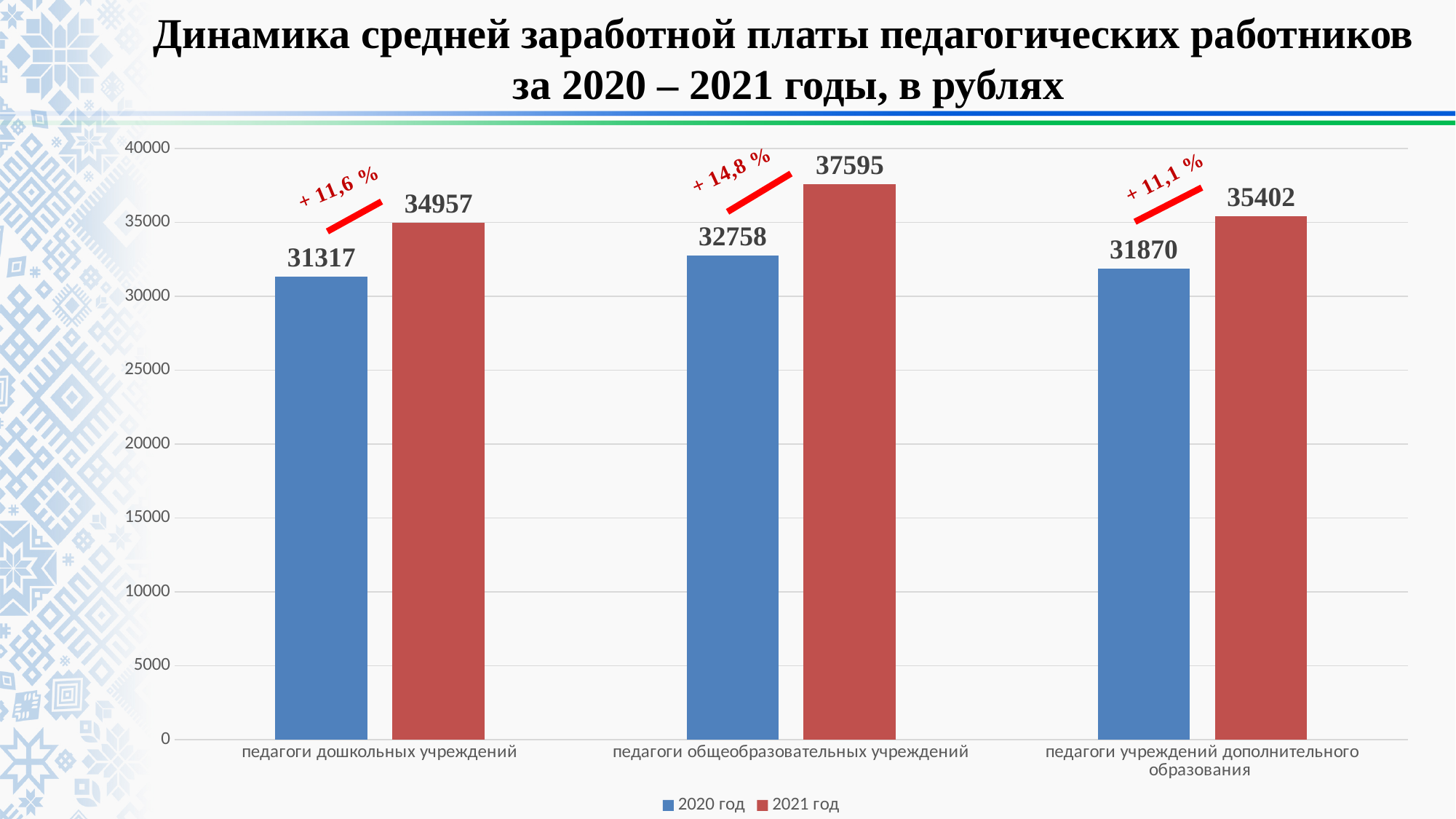
What is the difference between the 2021 год and 2020 год values for педагоги дошкольных учреждений? 3640 Is the 2021 год value for педагоги дошкольных учреждений greater or less than 35000? less Which is larger: the 2020 год value for педагоги учреждений дополнительного образования or the 2020 год value for педагоги общеобразовательных учреждений? педагоги общеобразовательных учреждений Which category has the highest 2021 год value? педагоги общеобразовательных учреждений What is the difference between the 2021 год and 2020 год values for педагоги общеобразовательных учреждений? 4837 How many categories are shown on the x axis? 3 What is the 2021 год value for педагоги общеобразовательных учреждений? 37595 What percentage increase is annotated for педагоги общеобразовательных учреждений? + 14,8 % What is the 2021 год value for педагоги учреждений дополнительного образования? 35402 Which category has the lowest 2020 год value? педагоги дошкольных учреждений What is the 2020 год value for педагоги дошкольных учреждений? 31317 How many series does the legend list? 2